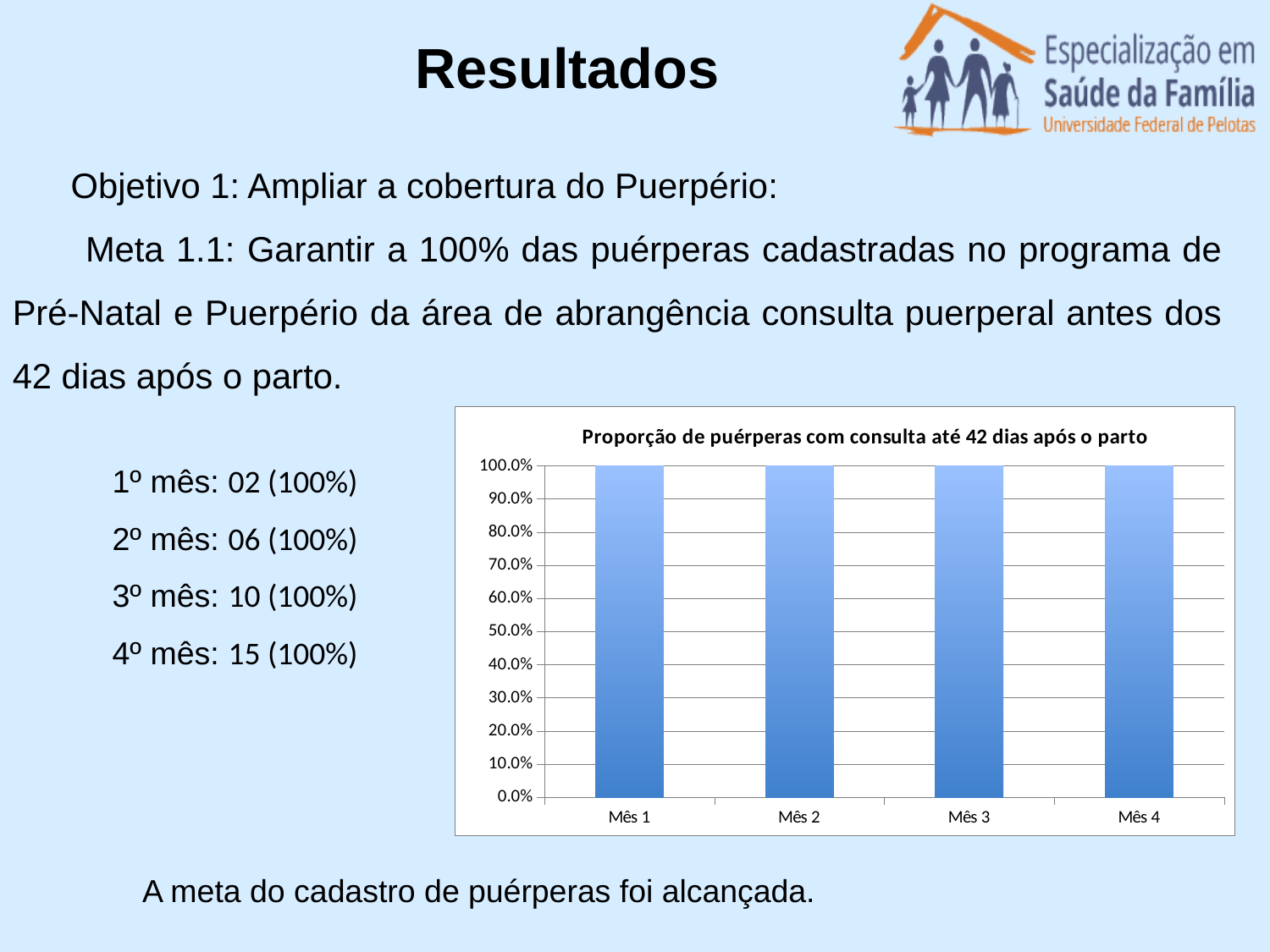
What is the difference between the values for Mês 4 and Mês 1? 0.0% What is the value for Mês 3 in the chart? 100.0% Do the values rise, fall, or stay the same from Mês 1 to Mês 4? stay the same What is the label of the first category on the x axis of the chart? Mês 1 What kind of chart is shown on the slide? bar chart How many categories (months) are plotted on the x axis of the chart? 4 Is the value for Mês 1 greater or less than 50.0%? greater What is the value for Mês 2 in the chart? 100.0% What is the value for Mês 4 in the chart? 100.0% What is the title of the chart? Proporção de puérperas com consulta até 42 dias após o parto Is the value for Mês 3 greater or less than 90.0%? greater What is the value for Mês 1 in the chart? 100.0%